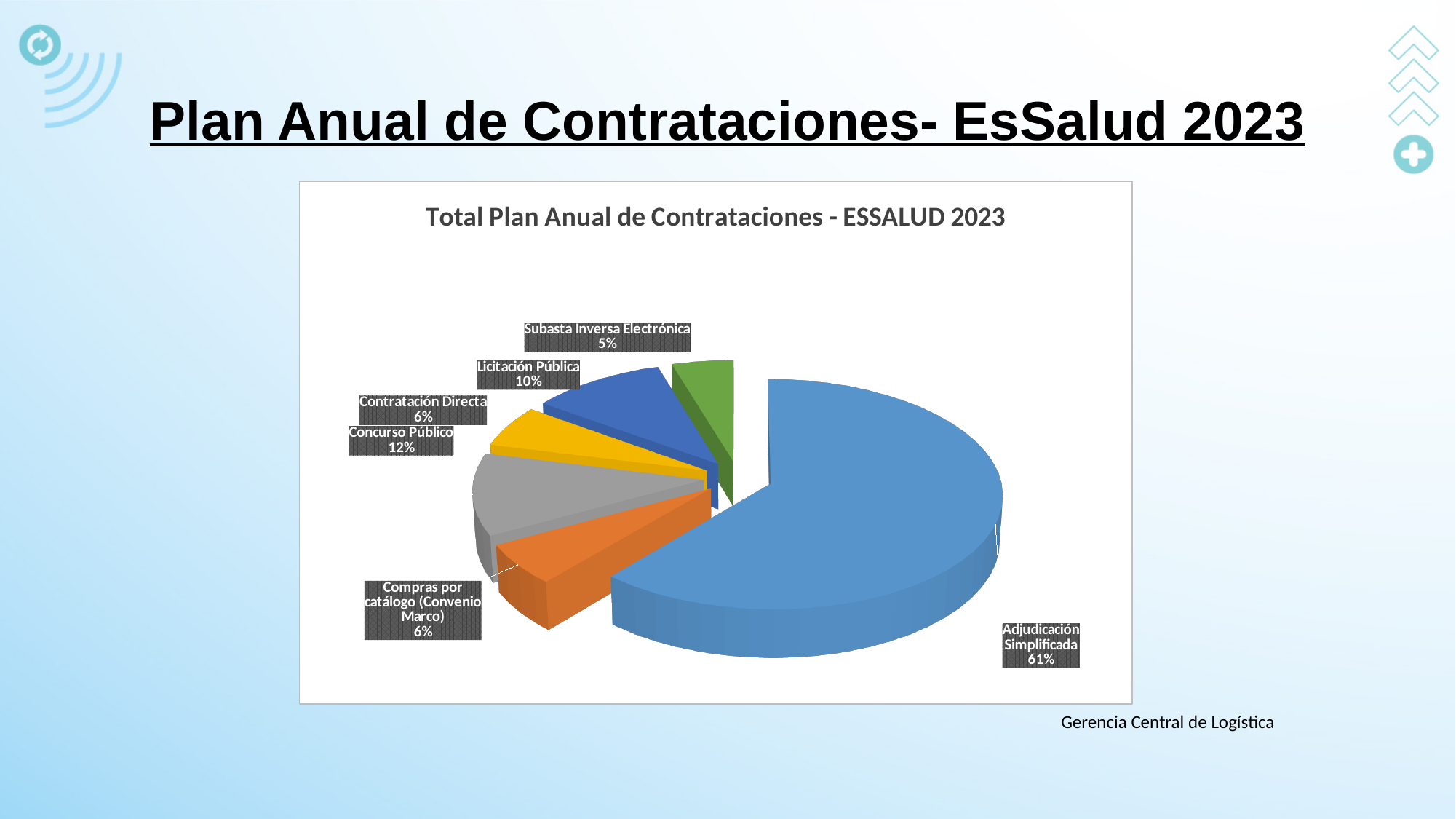
What share of the pie does Adjudicación Simplificada represent? 61% What percentage is shown for Subasta Inversa Electrónica? 5% What is the difference in percentage points between Adjudicación Simplificada and Concurso Público? 49 What percentage is shown for Concurso Público? 12% Which category has the largest share of the pie? Adjudicación Simplificada What is the title of the chart? Total Plan Anual de Contrataciones - ESSALUD 2023 What percentage is shown for Licitación Pública? 10% What kind of chart is shown on the slide? Pie chart How many categories (slices) does the pie chart have? 6 Which is larger, the share for Licitación Pública or the share for Contratación Directa? Licitación Pública Which category has the smallest share of the pie? Subasta Inversa Electrónica What percentage is shown for Compras por catálogo (Convenio Marco)? 6%